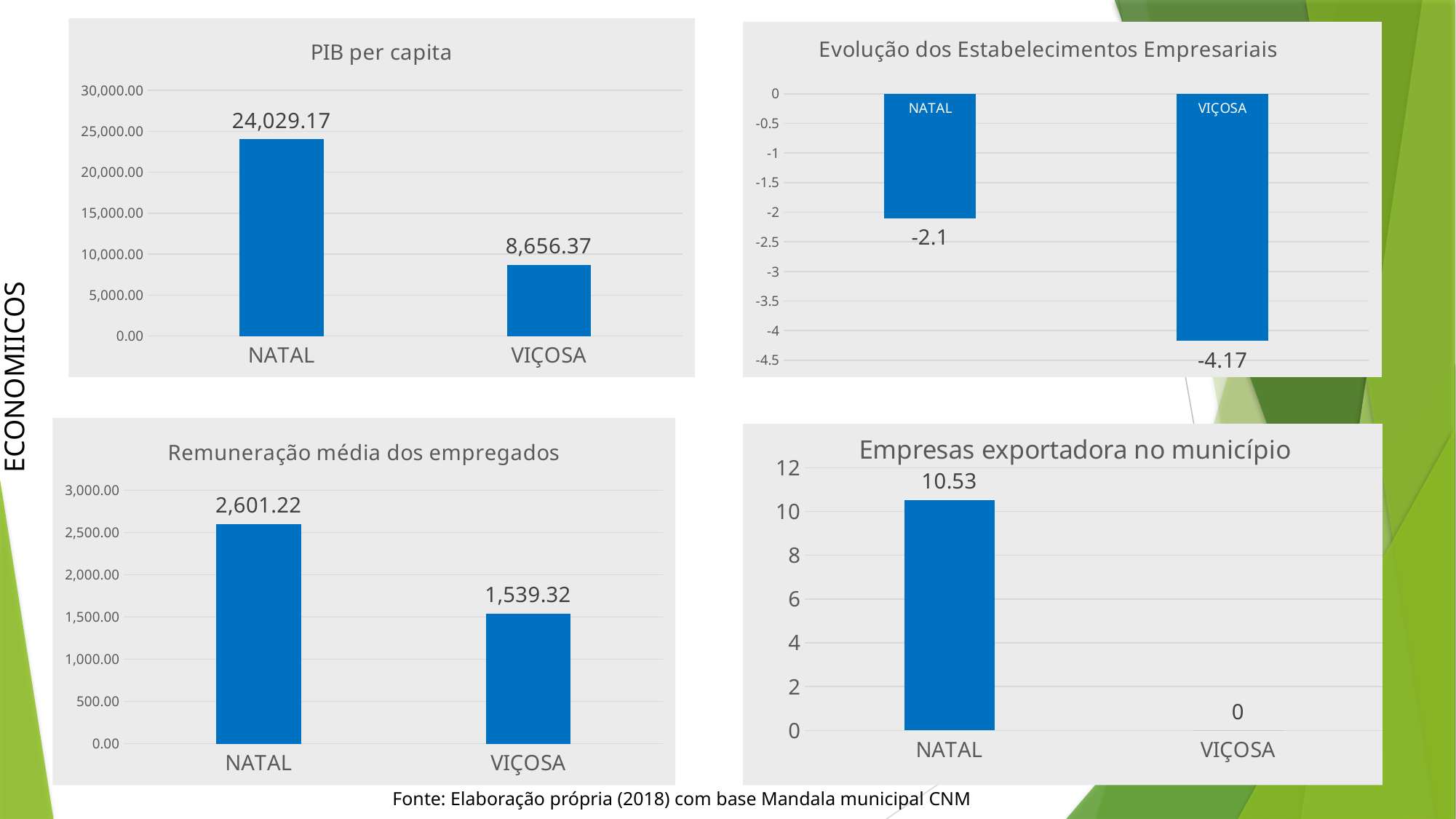
In the 'Evolução dos Estabelecimentos Empresariais' chart, which category has the lowest value? VIÇOSA In the 'Remuneração média dos empregados' chart, what is the difference between the NATAL and VIÇOSA values? 1,061.90 How many categories are shown in the 'Remuneração média dos empregados' chart? 2 In the 'Remuneração média dos empregados' chart, what is the value for VIÇOSA? 1,539.32 In the 'PIB per capita' chart, what is the value for VIÇOSA? 8,656.37 What type of chart is the 'PIB per capita' chart? Bar chart In the 'PIB per capita' chart, what is the value for NATAL? 24,029.17 In the 'Empresas exportadora no município' chart, what is the value for VIÇOSA? 0 In the 'Evolução dos Estabelecimentos Empresariais' chart, what is the value for VIÇOSA? -4.17 In the 'Empresas exportadora no município' chart, what is the value for NATAL? 10.53 In the 'PIB per capita' chart, which category has the highest value? NATAL In the 'Evolução dos Estabelecimentos Empresariais' chart, what is the value for NATAL? -2.1